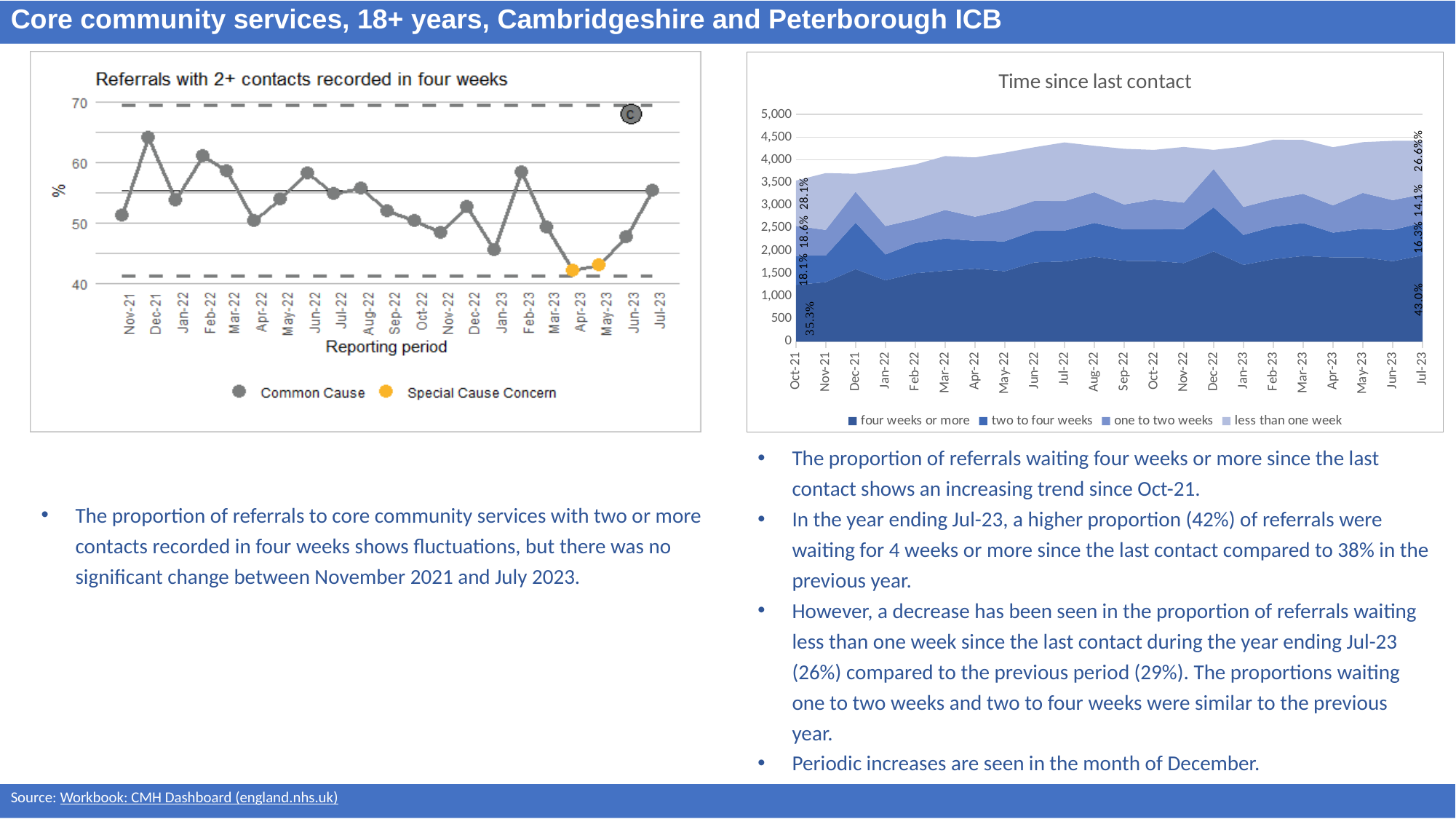
What kind of chart is the right chart titled 'Time since last contact'? Stacked area chart In the right chart 'Time since last contact', is the total at Jul-23 greater or less than 4,000? greater How many series does the legend of the left chart 'Referrals with 2+ contacts recorded in four weeks' list? 2 What kind of chart is the left chart titled 'Referrals with 2+ contacts recorded in four weeks'? Line chart In the left chart 'Referrals with 2+ contacts recorded in four weeks', how many points are marked as Special Cause Concern? 2 In the left chart 'Referrals with 2+ contacts recorded in four weeks', is the value for Dec-21 greater or less than 60? greater In the right chart 'Time since last contact', what percentage label is shown for 'less than one week' at Oct-21? 28.1% In the right chart 'Time since last contact', what percentage label is shown for 'four weeks or more' at Jul-23? 43.0% How many series does the legend of the right chart 'Time since last contact' list? 4 In the left chart 'Referrals with 2+ contacts recorded in four weeks', which reporting period has the highest value? Dec-21 In the left chart 'Referrals with 2+ contacts recorded in four weeks', is the value for Apr-23 greater or less than 50? less How many reporting periods are plotted on the x axis of the left chart 'Referrals with 2+ contacts recorded in four weeks'? 21